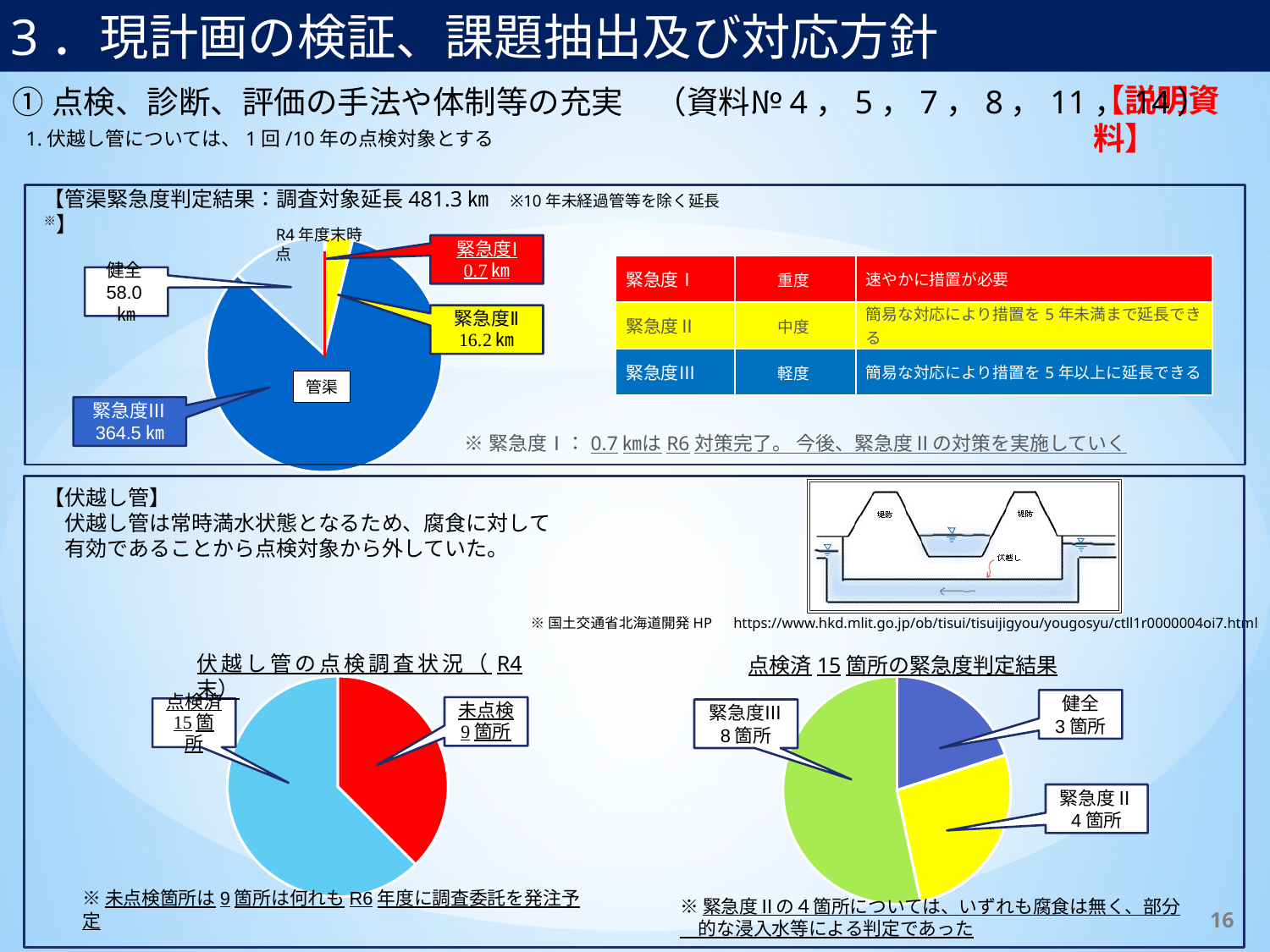
「伏越し管の点検調査状況（R4末）」のグラフで、点検済と未点検ではどちらが多いですか？ 点検済 【管渠緊急度判定結果】の円グラフで、緊急度Iの延長はいくらですか？ 0.7 km 「伏越し管の点検調査状況（R4末）」のグラフで、未点検の箇所数はいくつですか？ 9箇所 「点検済15箇所の緊急度判定結果」のグラフで、最も箇所数が少ない区分はどれですか？ 健全 【管渠緊急度判定結果】の円グラフで、健全と緊急度IIの延長の差はいくらですか？ 41.8 km 【管渠緊急度判定結果】の円グラフで、最も延長が大きい区分はどれですか？ 緊急度III 「伏越し管の点検調査状況（R4末）」のグラフはどの種類のグラフですか？ 円グラフ 【管渠緊急度判定結果】の円グラフは何種類の区分に分かれていますか？ 4 「点検済15箇所の緊急度判定結果」のグラフで、緊急度IIIの箇所数はいくつですか？ 8箇所 「点検済15箇所の緊急度判定結果」のグラフで、緊急度IIIと緊急度IIの箇所数の差はいくつですか？ 4箇所 【管渠緊急度判定結果】の円グラフで、最も延長が小さい区分はどれですか？ 緊急度I 【管渠緊急度判定結果】の円グラフで、緊急度IIIの延長はいくらですか？ 364.5 km